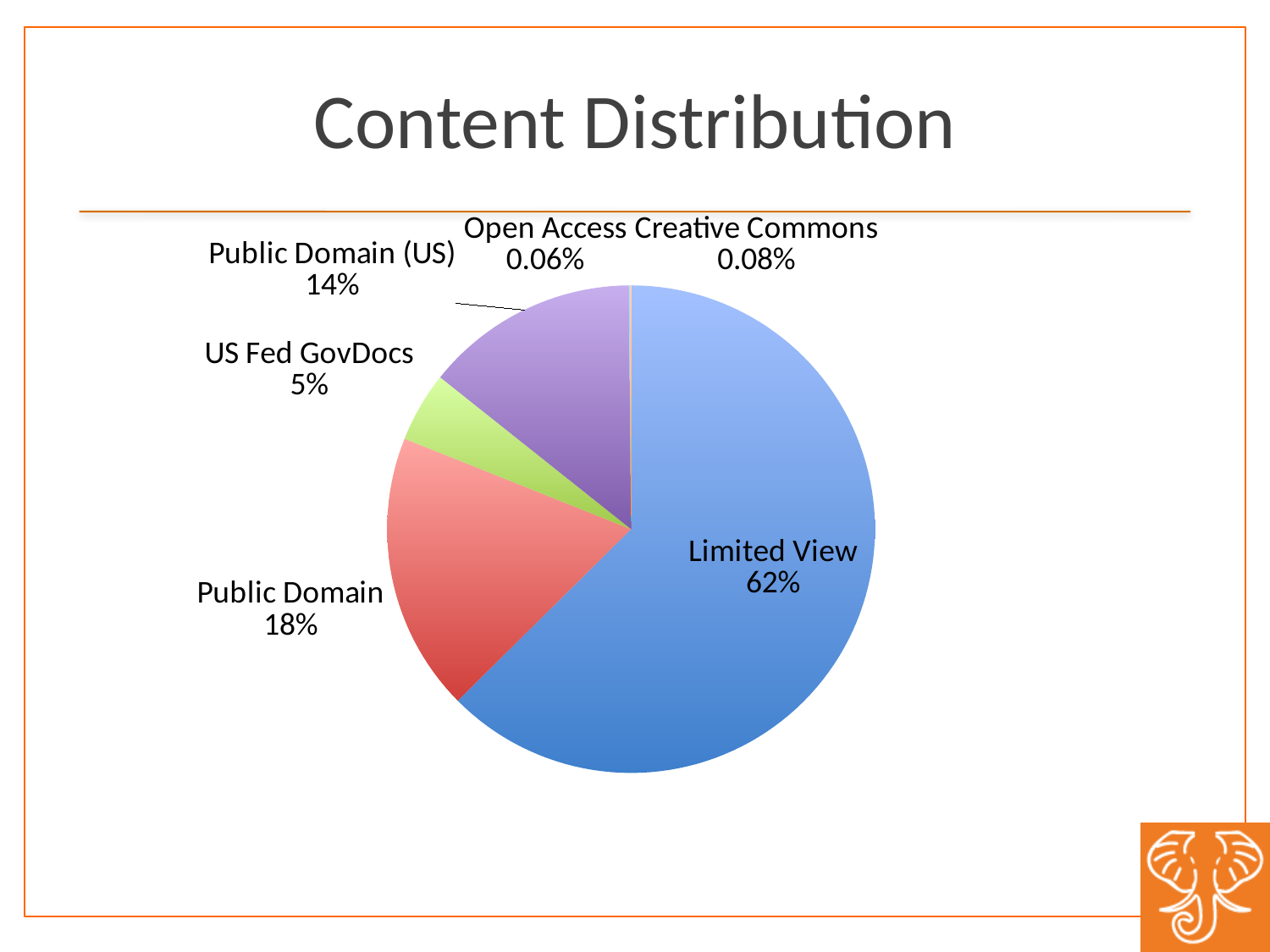
What share of the pie is Open Access? 0.06% What kind of chart is shown on the slide? pie chart How many categories are shown in the pie chart? 6 What share of the pie is Creative Commons? 0.08% What is the difference between the Public Domain share and the Public Domain (US) share? 4% Which category has the smallest share of the pie? Open Access What share of the pie is Public Domain? 18% What share of the pie is US Fed GovDocs? 5% What is the title of the chart? Content Distribution What share of the pie is Public Domain (US)? 14% Which category has the largest share of the pie? Limited View What share of the pie is Limited View? 62%